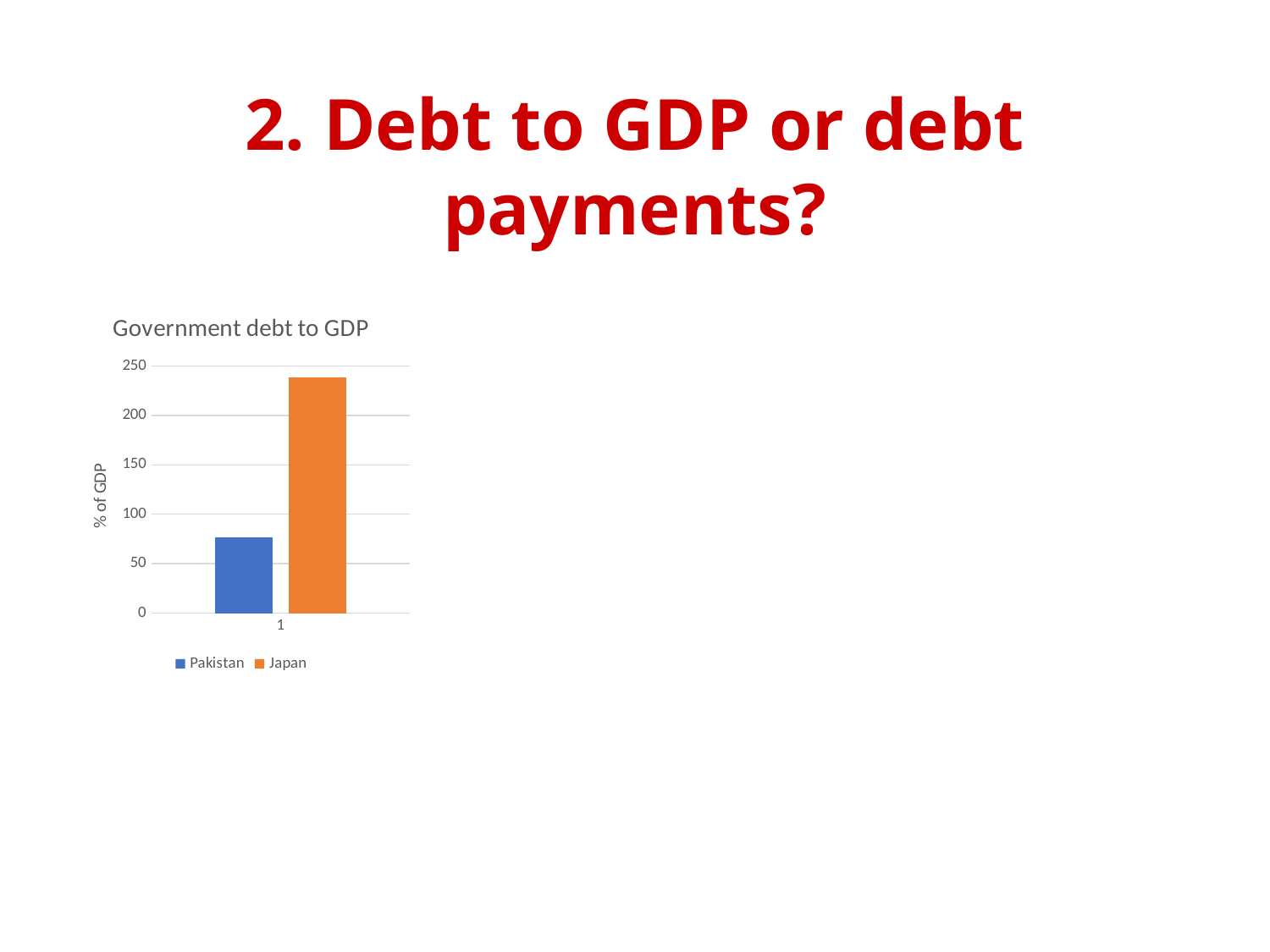
Which series has the highest value in the chart? Japan Is the value for Pakistan greater or less than 100? less What is the label on the vertical axis of the chart? % of GDP Which series has the higher government debt to GDP, Pakistan or Japan? Japan Is the value for Japan greater or less than 200? greater What kind of chart is shown on the slide? bar chart How many categories are shown on the x axis? 1 How many series does the legend list? 2 Is the value for Pakistan greater or less than 50? greater Which series has the lowest value in the chart? Pakistan What is the title of the chart? Government debt to GDP